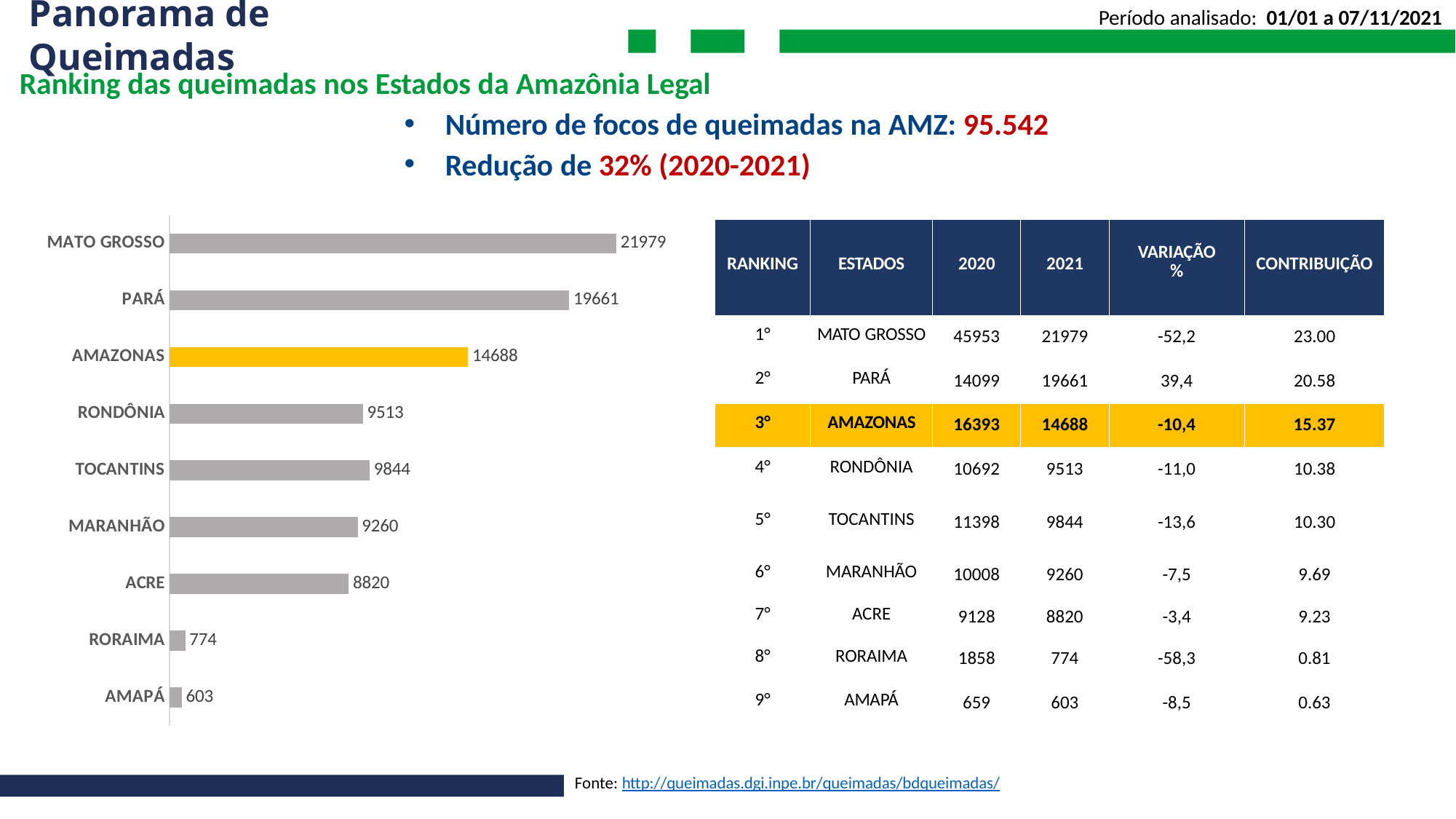
What kind of chart is shown on the slide? bar chart What is the difference between the values for MATO GROSSO and PARÁ in the bar chart? 2318 How many states are shown in the bar chart? 9 Which bar in the chart is highlighted in yellow? AMAZONAS What is the difference between the values for MARANHÃO and ACRE in the bar chart? 440 What is the value for AMAZONAS in the bar chart? 14688 Which has a larger value in the bar chart, TOCANTINS or RONDÔNIA? TOCANTINS What is the value for MATO GROSSO in the bar chart? 21979 What is the value for RORAIMA in the bar chart? 774 Which state has the highest value in the bar chart? MATO GROSSO What is the value for TOCANTINS in the bar chart? 9844 Which state has the lowest value in the bar chart? AMAPÁ